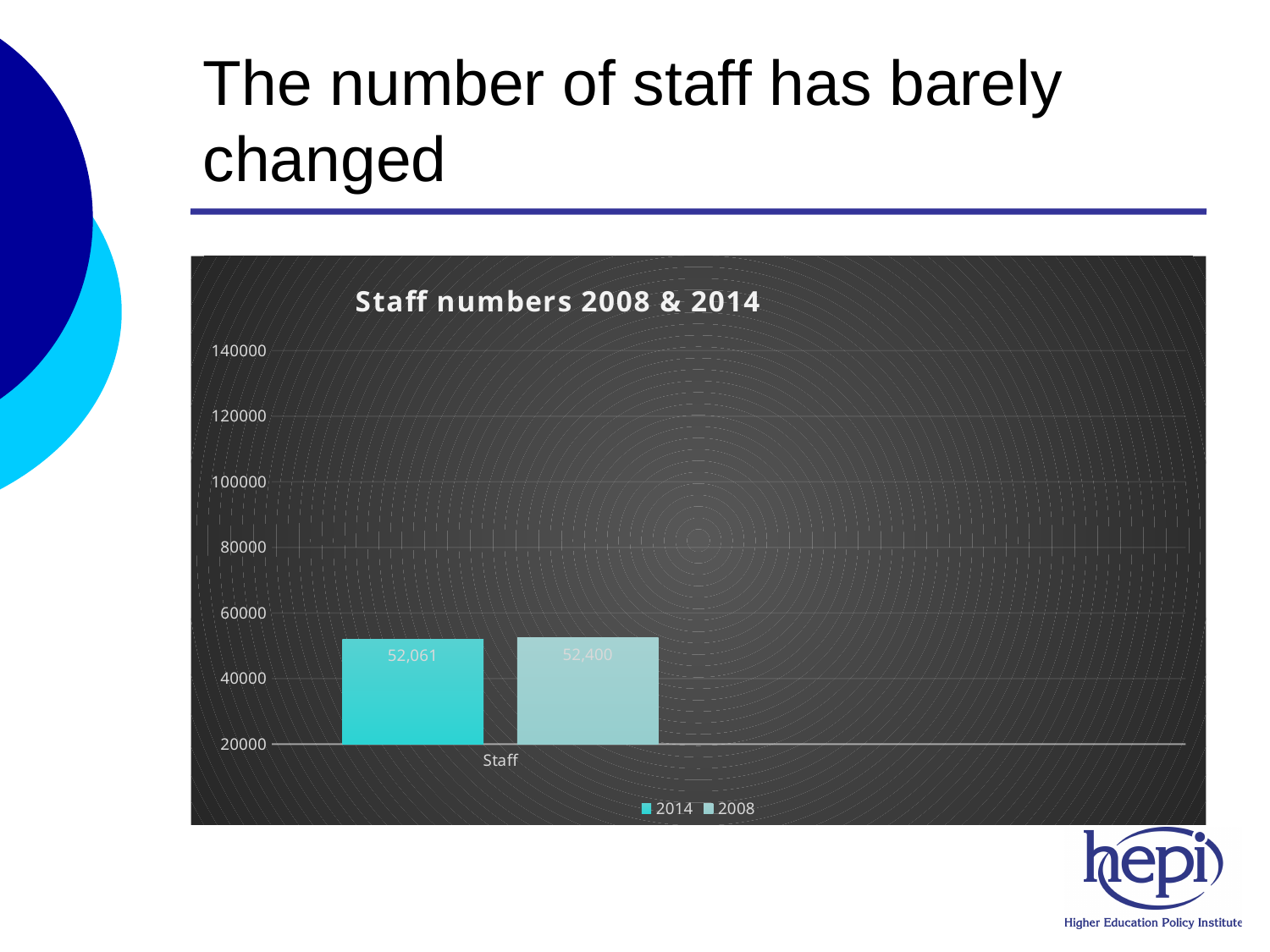
Is the value for 2008 greater or less than 40000? greater What is the difference between the 2008 and 2014 staff numbers? 339 What kind of chart is shown on the slide? bar chart Is the value for 2014 greater or less than 60000? less Which series has the larger value, 2008 or 2014? 2008 What is the label of the category on the x axis? Staff How many series does the legend list? 2 What is the highest value shown on the y axis of the chart? 140000 How many categories are shown on the x axis of the chart? 1 What is the title of the chart? Staff numbers 2008 & 2014 What is the value for 2014 in the Staff numbers 2008 & 2014 chart? 52,061 What is the value for 2008 in the Staff numbers 2008 & 2014 chart? 52,400